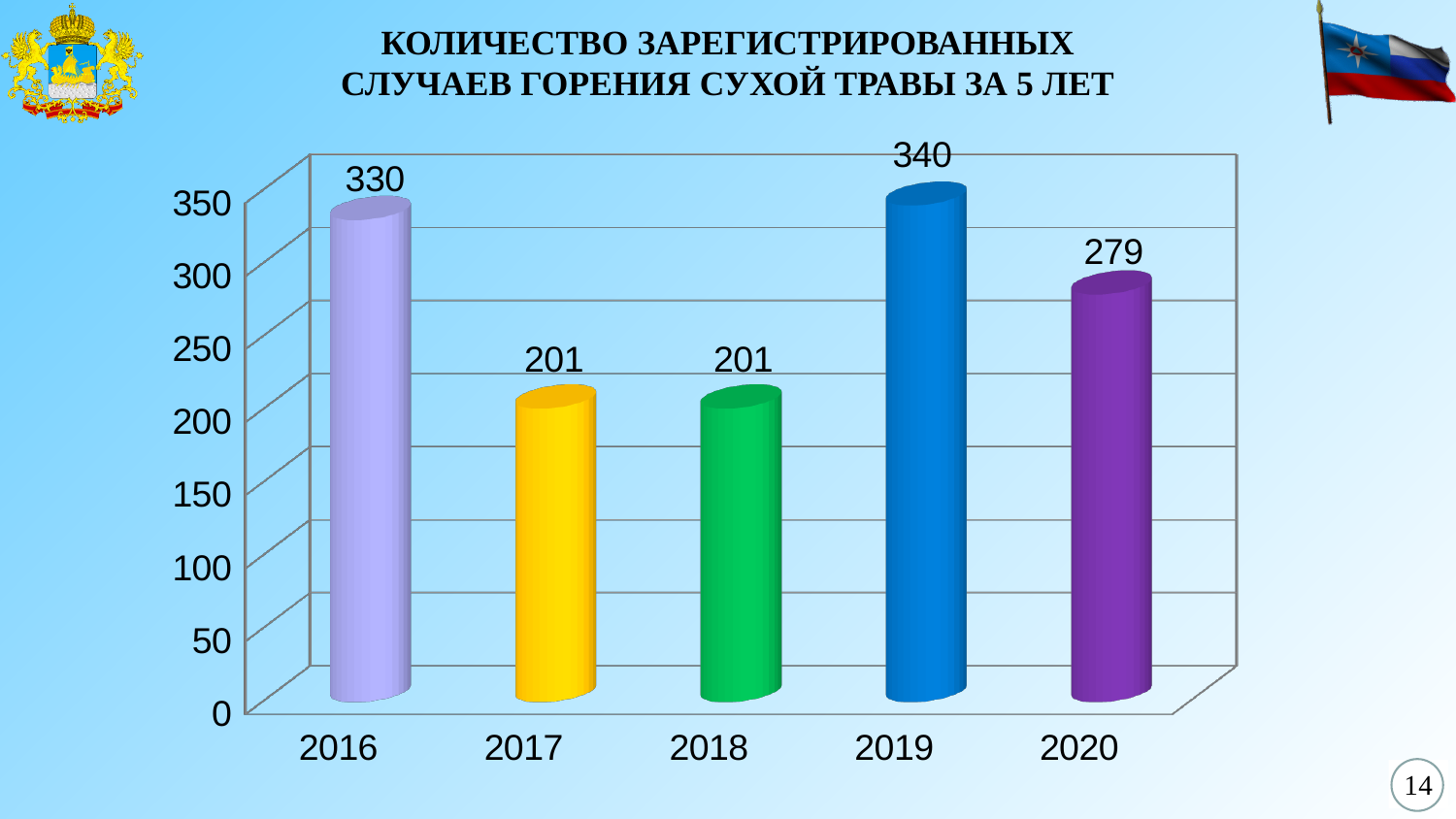
What kind of chart is shown on the slide? bar chart What is the difference between the values for 2019 and 2020? 61 What is the value for 2017? 201 What is the value for 2019? 340 Is the value for 2018 greater or less than 250? less How many years are shown on the x axis? 5 Which is larger, the value for 2016 or the value for 2020? 2016 What is the value for 2020? 279 What is the difference between the values for 2016 and 2017? 129 What is the value for 2016? 330 Do the values rise or fall from 2019 to 2020? fall Which year has the highest value? 2019